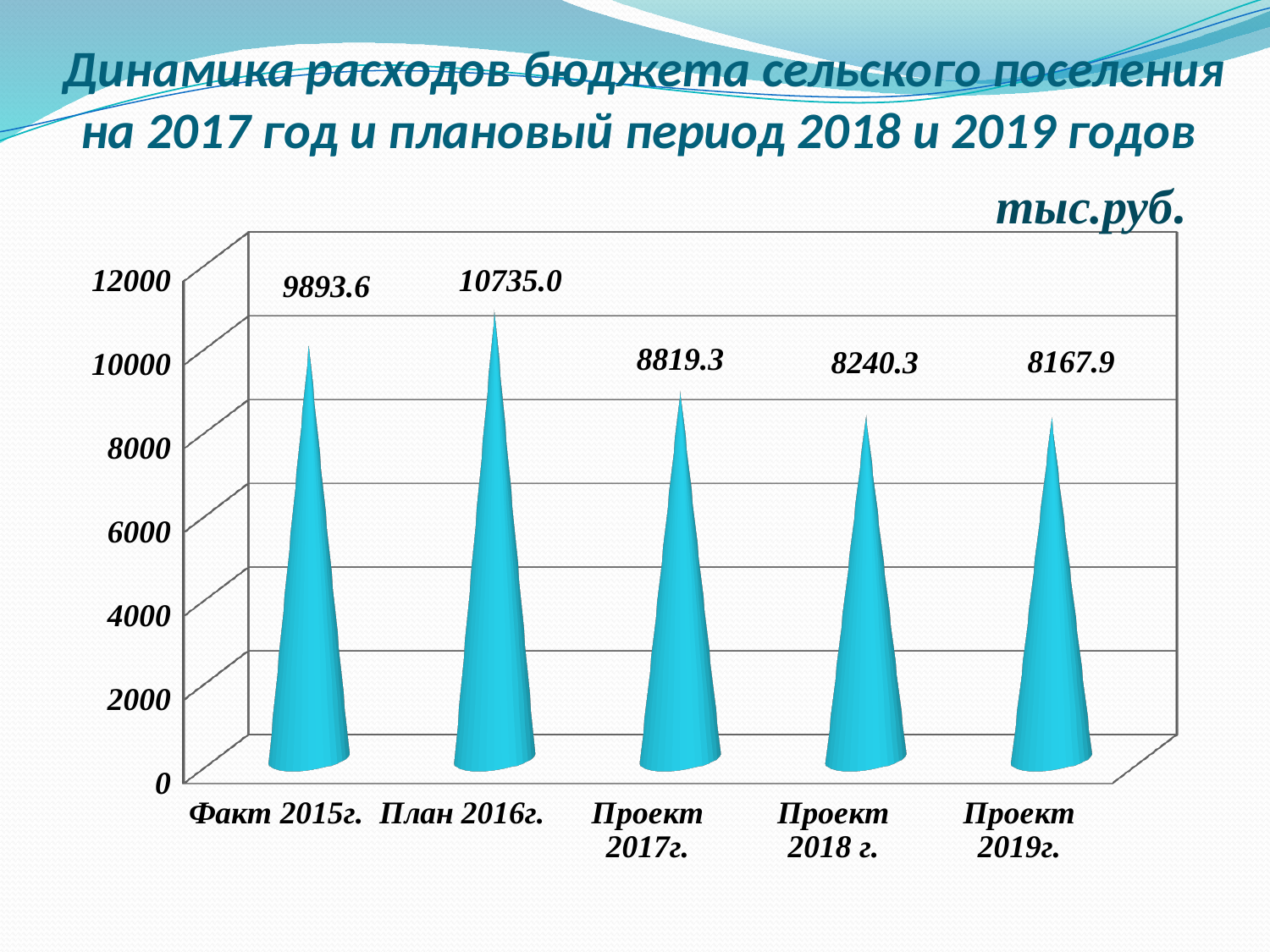
What is the difference between the values for Проект 2018 г. and Проект 2019г.? 72.4 What is the value for Факт 2015г.? 9893.6 How many categories are shown on the x axis? 5 What unit is indicated above the chart? тыс.руб. What kind of chart is shown on the slide? bar chart Which category has the highest value? План 2016г. What is the difference between the values for План 2016г. and Проект 2017г.? 1915.7 What is the value for Проект 2017г.? 8819.3 Which is larger, the value for Факт 2015г. or the value for Проект 2017г.? Факт 2015г. What is the value for Проект 2019г.? 8167.9 Which category has the lowest value? Проект 2019г. What is the value for План 2016г.? 10735.0